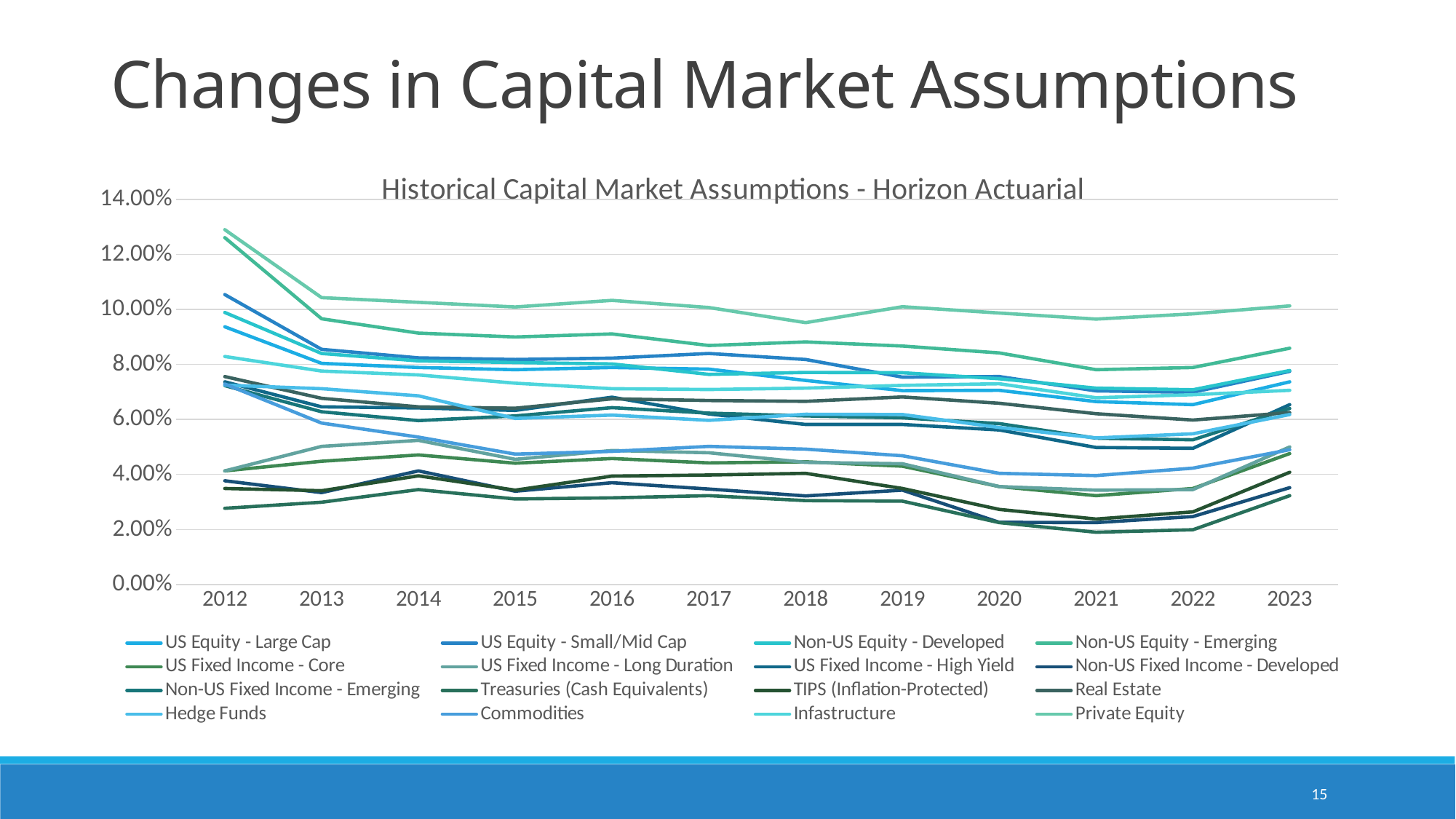
How many series does the legend list? 16 Does the topmost line rise or fall between 2012 and 2013? fall What kind of chart is shown on the slide? Line chart What is the last year shown on the x axis? 2023 Is the highest value plotted in 2021 greater or less than 8.00%? greater How many years are shown along the x axis? 12 What is the title of the chart? Historical Capital Market Assumptions - Horizon Actuarial Is the highest value plotted in 2012 greater or less than 12.00%? greater In which year does the topmost line reach its highest value? 2012 Is the lowest value plotted in 2023 greater or less than 4.00%? less What is the first year shown on the x axis? 2012